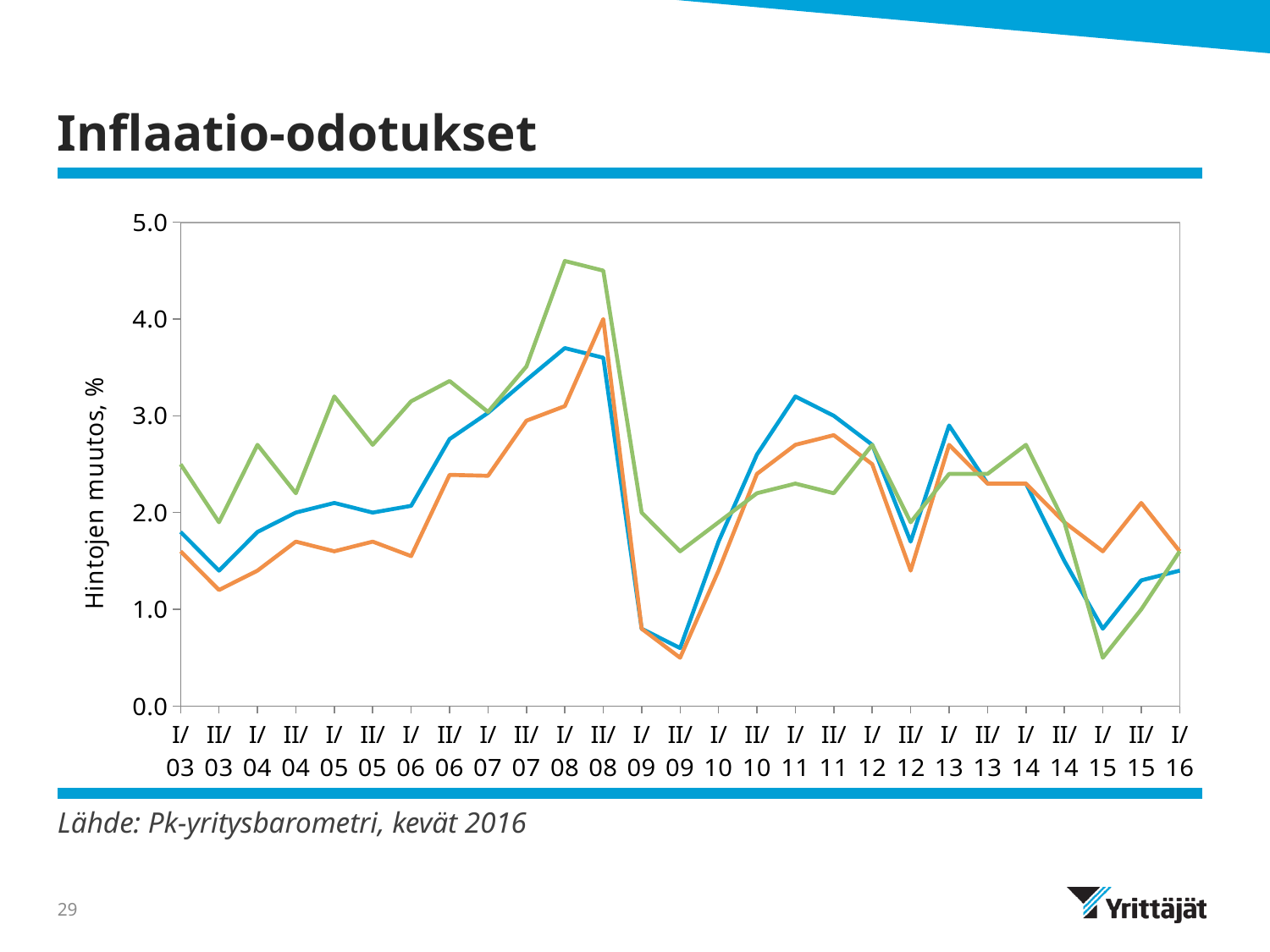
Is the value of the green line at I/15 greater or less than 1.0? less Is the value of the orange line at II/09 greater or less than 1.0? less At II/11, which line is higher, the orange line or the green line? orange What kind of chart is shown on the slide? line chart How many time periods are shown along the x axis of the chart? 27 In which period does the green line reach its lowest value? I/15 Is the value of the green line at I/08 greater or less than 4.0? greater In which period does the orange line reach its highest value? II/08 What is the label on the y axis of the chart? Hintojen muutos, % How many lines are plotted on the chart? 3 What is the title of the chart slide? Inflaatio-odotukset